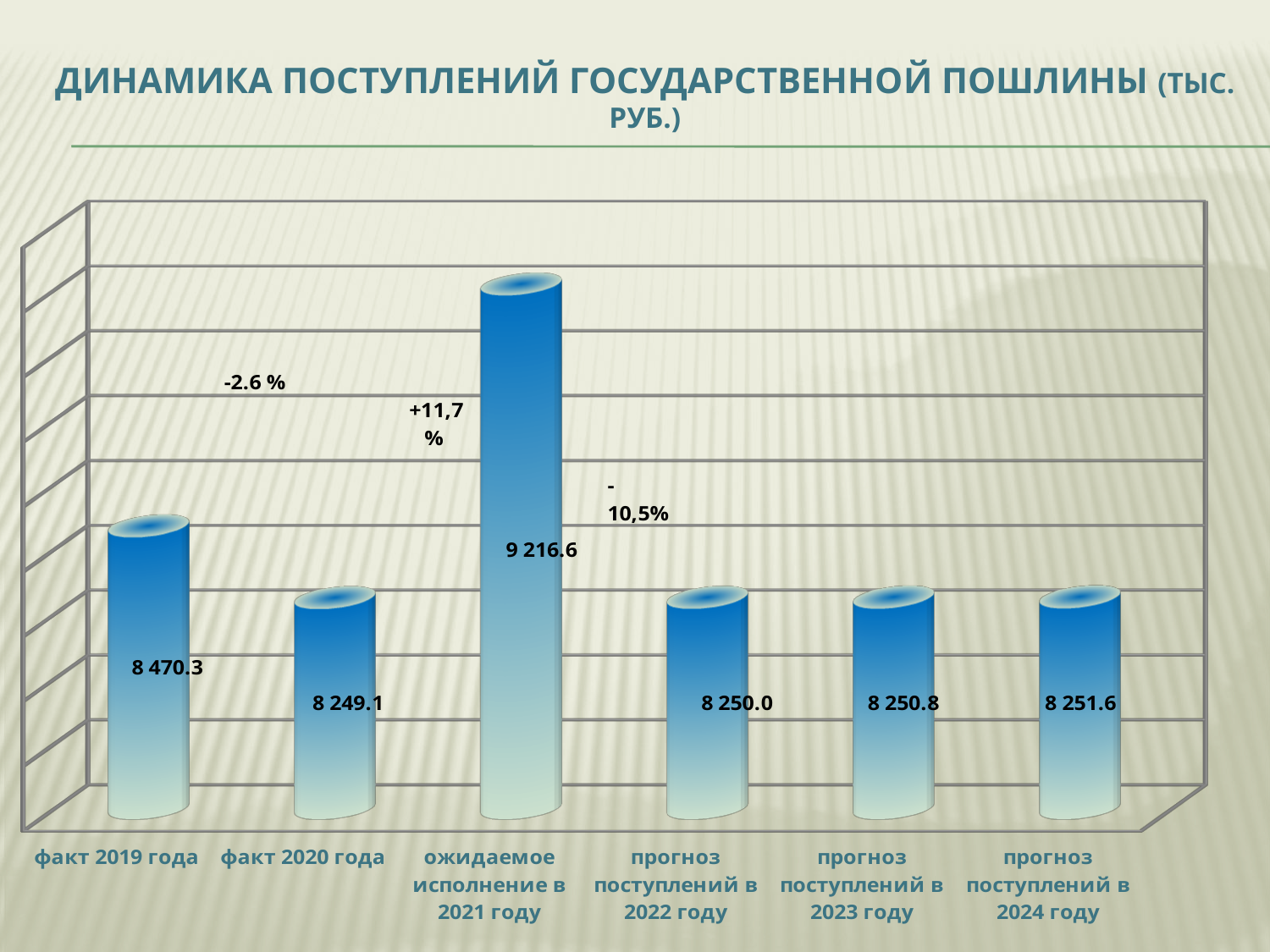
What is the value for факт 2019 года? 8 470.3 What is the difference between the value for ожидаемое исполнение в 2021 году and the value for факт 2019 года? 746.3 Which category has the highest value? ожидаемое исполнение в 2021 году What is the value for прогноз поступлений в 2024 году? 8 251.6 What is the difference between the value for факт 2019 года and the value for факт 2020 года? 221.2 What is the value for факт 2020 года? 8 249.1 What kind of chart is shown on the slide? bar chart Do the values rise or fall across the forecast years from 2022 to 2024? rise Which is larger, the value for факт 2019 года or the value for факт 2020 года? факт 2019 года What is the value for ожидаемое исполнение в 2021 году? 9 216.6 How many categories are shown on the x axis? 6 What percentage change is annotated above the bar for факт 2020 года? -2.6 %